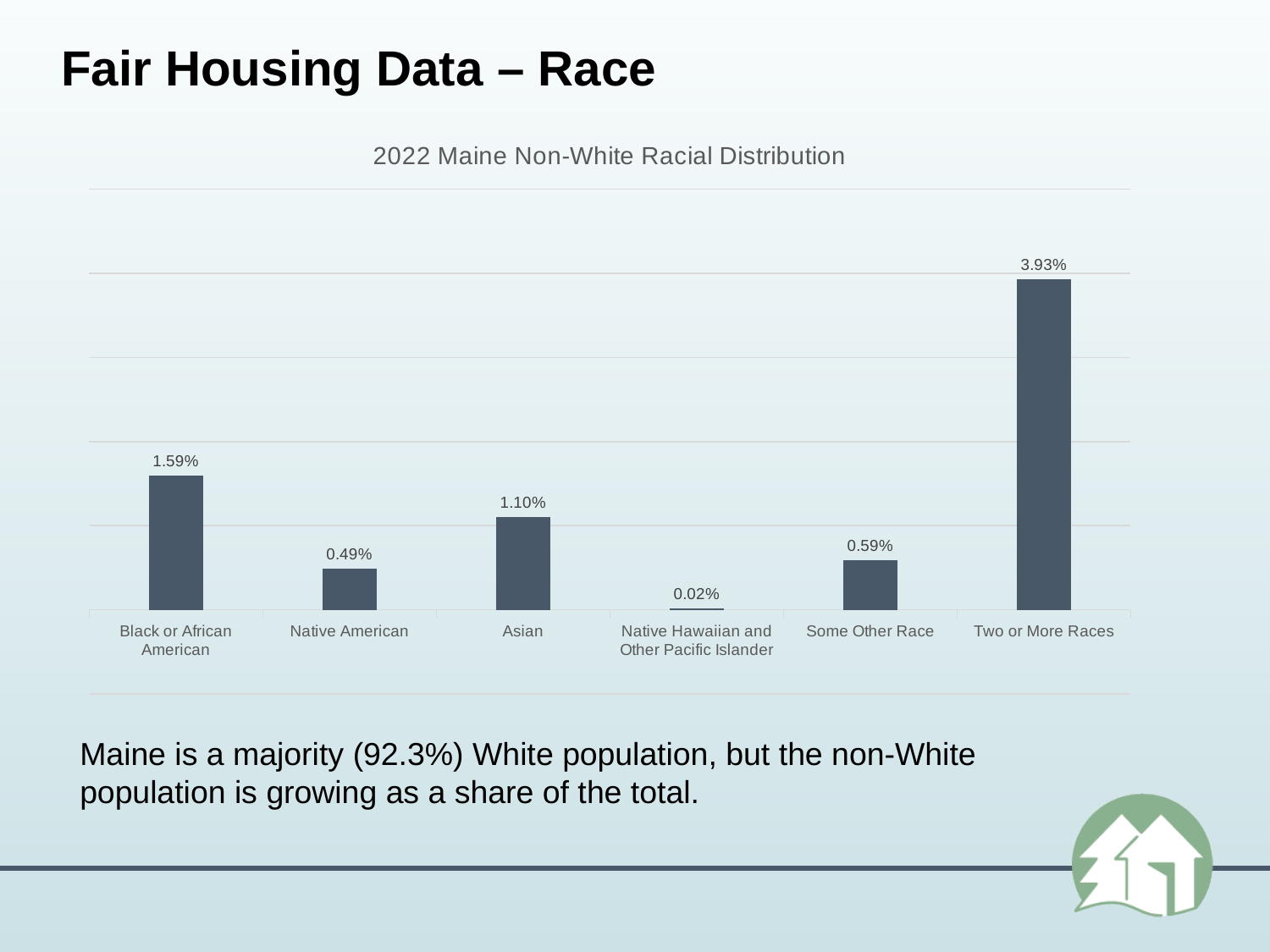
Which category has the lowest value? Native Hawaiian and Other Pacific Islander What is the value for Asian? 1.10% How many categories are shown on the x axis? 6 Which category has the highest value? Two or More Races What kind of chart is shown on the slide? Bar chart What is the value for Native Hawaiian and Other Pacific Islander? 0.02% Which is larger, the value for Asian or the value for Some Other Race? Asian What is the title of the chart? 2022 Maine Non-White Racial Distribution What is the difference between the values for Two or More Races and Black or African American? 2.34% What is the value for Black or African American? 1.59% What is the value for Some Other Race? 0.59% What is the value for Native American? 0.49%